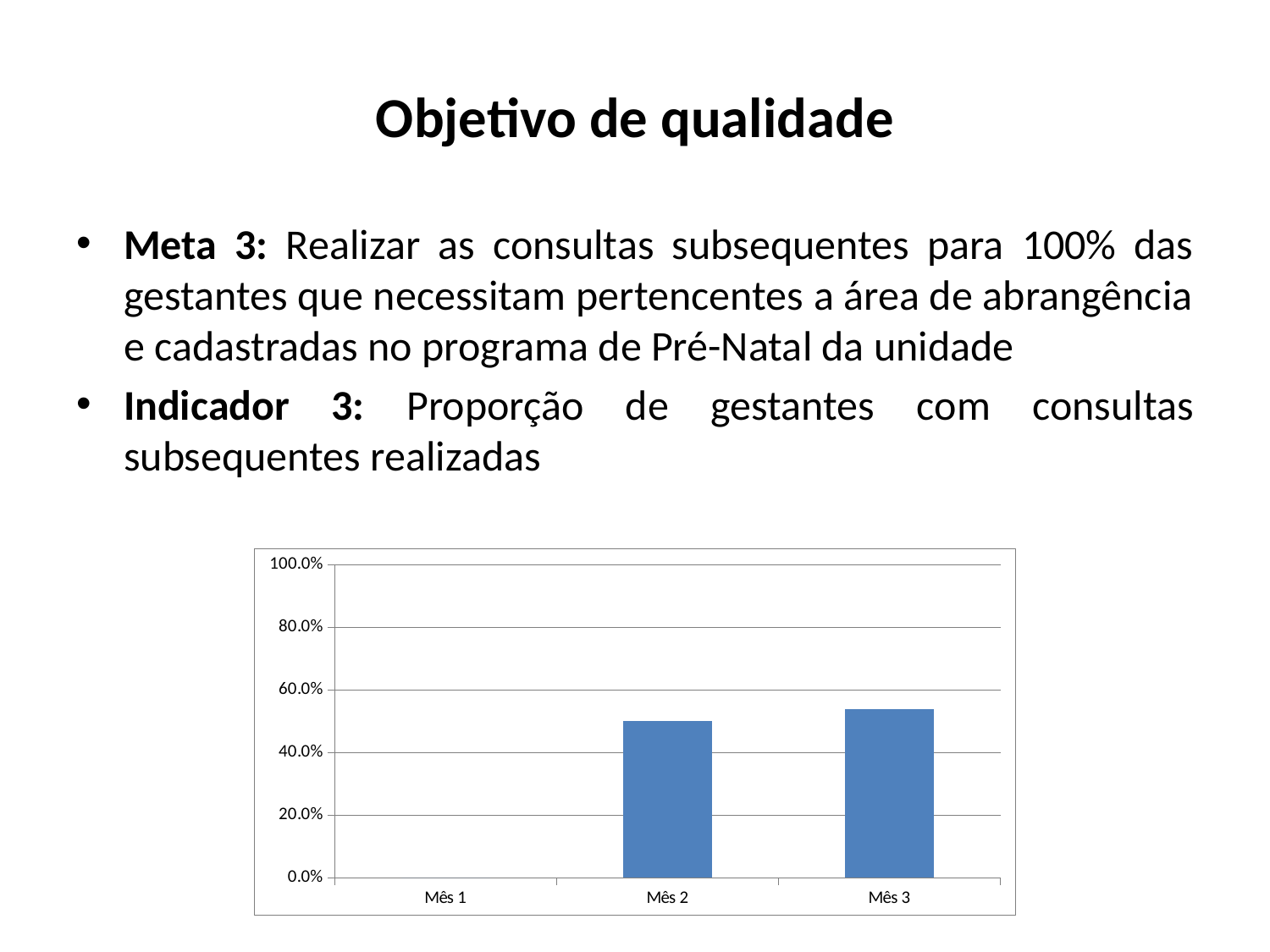
What is the highest value shown on the chart's vertical axis? 100.0% Is the value for Mês 2 greater or less than 40.0%? greater Which month has the highest value in the chart? Mês 3 Is the value for Mês 3 greater or less than 40.0%? greater Is the value for Mês 2 greater or less than 60.0%? less How many categories are shown on the x axis of the chart? 3 What kind of chart is shown on the slide? bar chart Do the values rise or fall from Mês 1 to Mês 3? rise Which is larger, the value for Mês 2 or the value for Mês 3? Mês 3 Which month has the lowest value in the chart? Mês 1